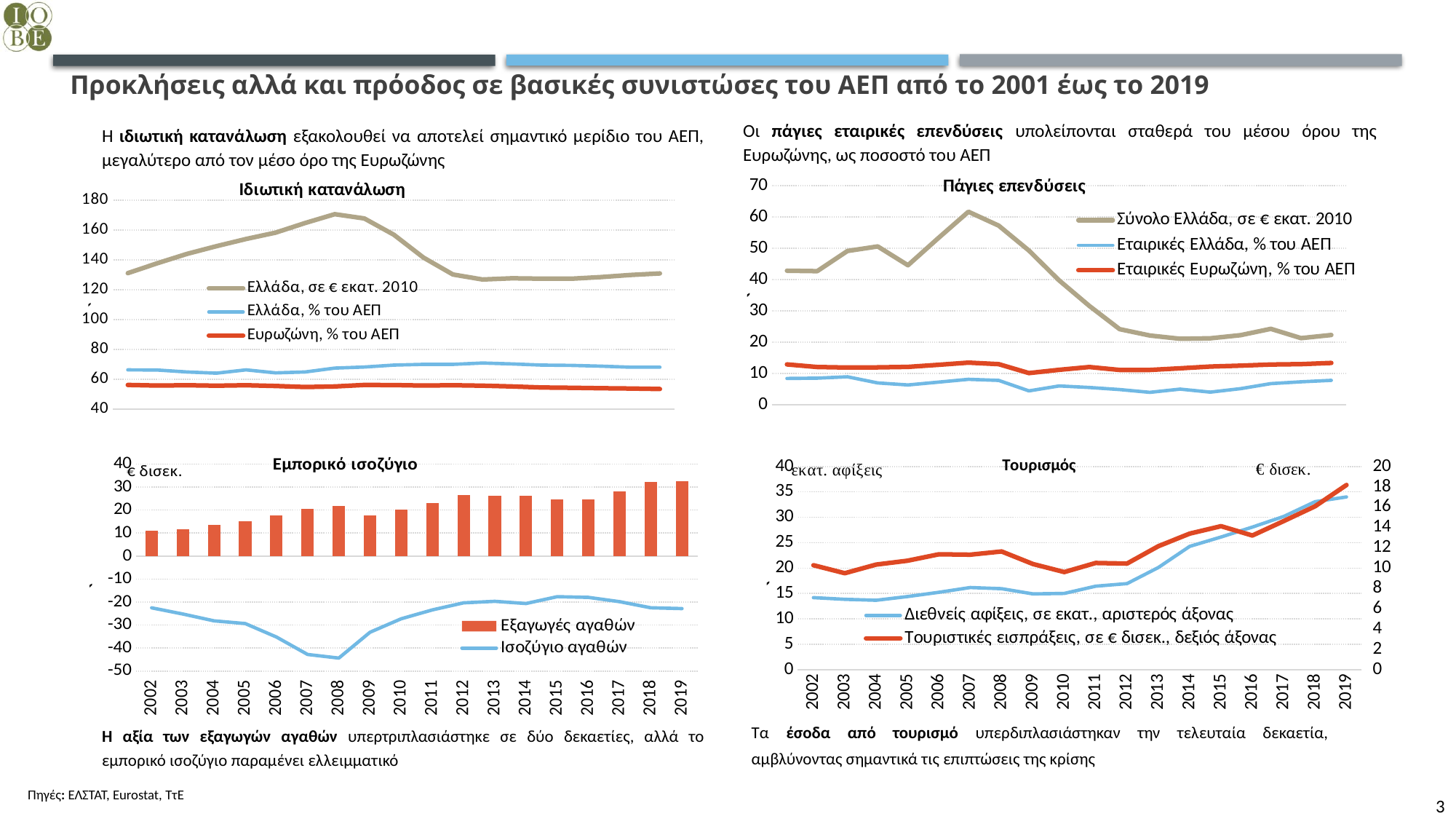
How many series does the legend of the 'Πάγιες επενδύσεις' chart list? 3 What kind of chart is the 'Ιδιωτική κατανάλωση' chart? line chart In the 'Εμπορικό ισοζύγιο' chart, is the value of 'Εξαγωγές αγαθών' for 2002 greater or less than 20? less In the 'Εμπορικό ισοζύγιο' chart, is the value of 'Εξαγωγές αγαθών' for 2012 greater or less than 20? greater In the 'Εμπορικό ισοζύγιο' chart, how many years are shown on the x axis? 18 In the 'Τουρισμός' chart, is the value of 'Διεθνείς αφίξεις' for 2002 greater or less than 20 on the left axis? less In the 'Εμπορικό ισοζύγιο' chart, which series is shown as bars? Εξαγωγές αγαθών In the 'Τουρισμός' chart, do the 'Τουριστικές εισπράξεις' values rise or fall from 2012 to 2019? rise How many series does the legend of the 'Ιδιωτική κατανάλωση' chart list? 3 In the 'Πάγιες επενδύσεις' chart, which series is drawn in red? Εταιρικές Ευρωζώνης, % του ΑΕΠ